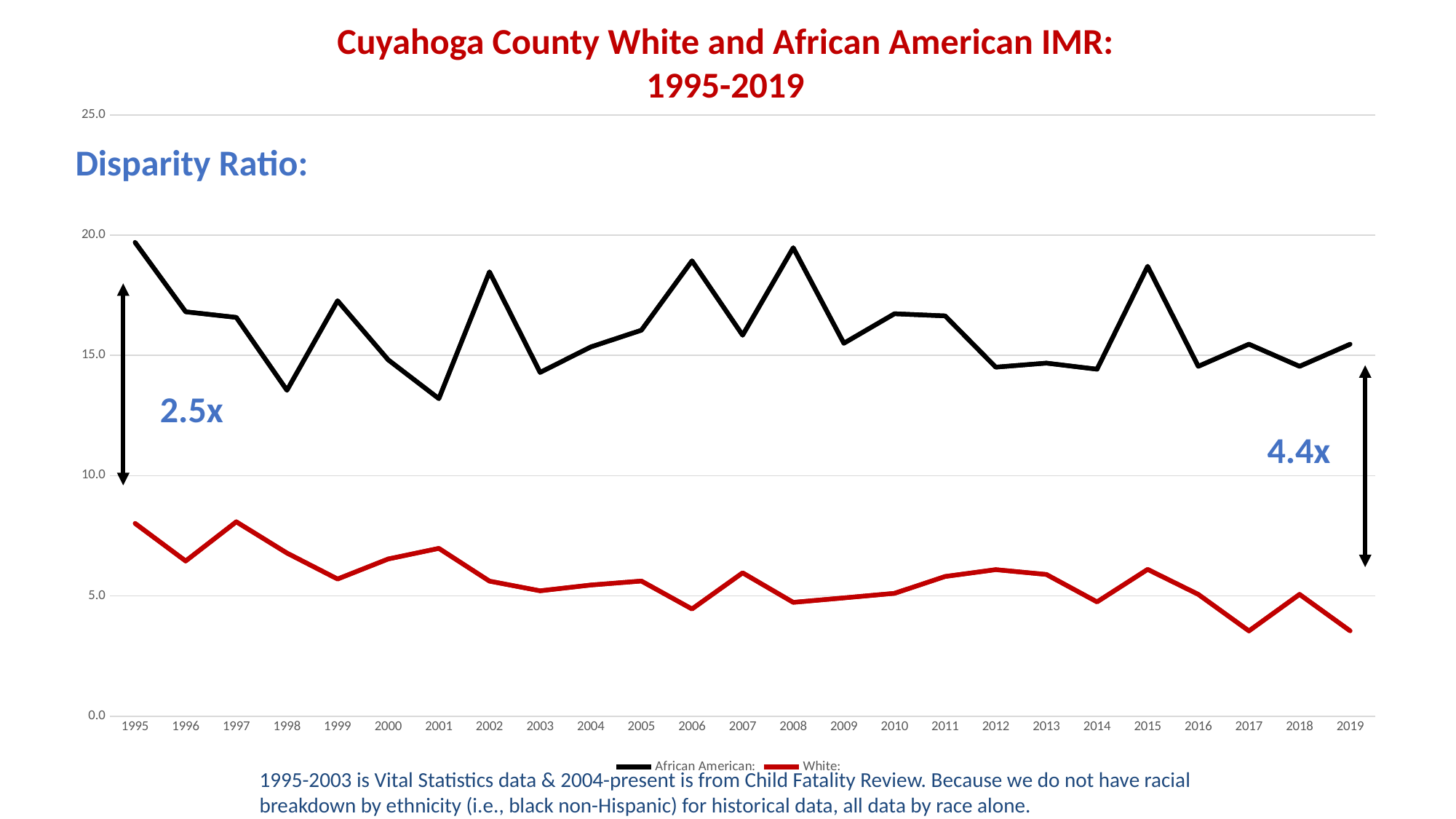
What disparity ratio is annotated at the right end of the chart (2019)? 4.4x What kind of chart is shown on the slide? line chart Is the White value for 2019 greater or less than 5.0? less Is the White value for 1997 greater or less than 5.0? greater Is the African American value for 1995 greater or less than 15.0? greater How many years are plotted along the x axis? 25 Does the White series overall rise or fall from 1995 to 2019? fall What is the title of the chart? Cuyahoga County White and African American IMR: 1995-2019 In 2010, which series has the larger value, African American or White? African American How many series does the legend list? 2